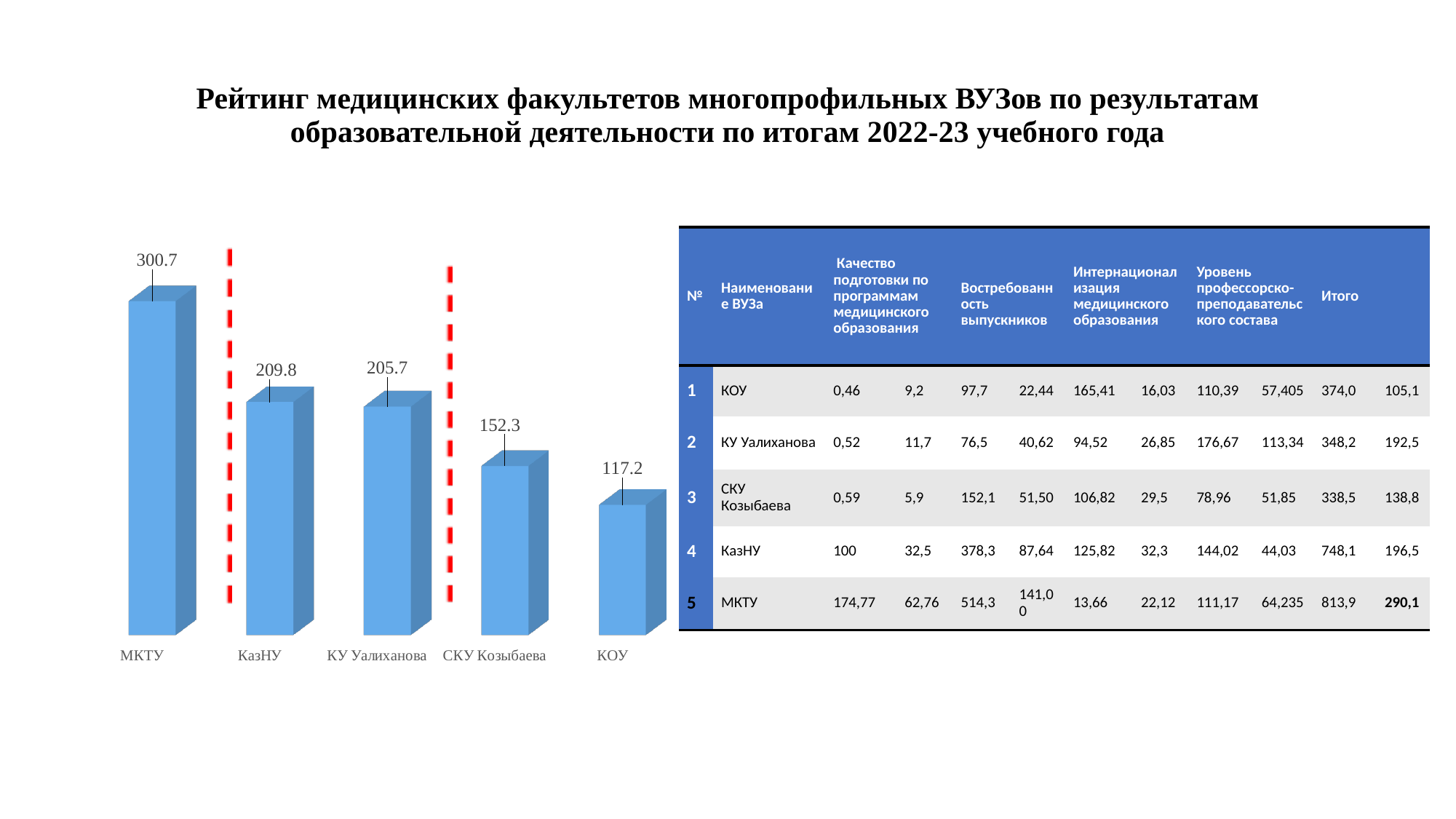
How many universities are shown in the bar chart? 5 What is the value shown for КОУ in the bar chart? 117.2 What is the difference between the values for МКТУ and КазНУ in the bar chart? 90.9 What is the difference between the values for СКУ Козыбаева and КОУ in the bar chart? 35.1 What is the value shown for МКТУ in the bar chart? 300.7 What type of chart is shown on the slide? Bar chart Which has a larger value in the bar chart, КазНУ or СКУ Козыбаева? КазНУ What is the value shown for СКУ Козыбаева in the bar chart? 152.3 Which university has the lowest value in the bar chart? КОУ Which university has the highest value in the bar chart? МКТУ What is the value shown for КУ Уалиханова in the bar chart? 205.7 What is the value shown for КазНУ in the bar chart? 209.8